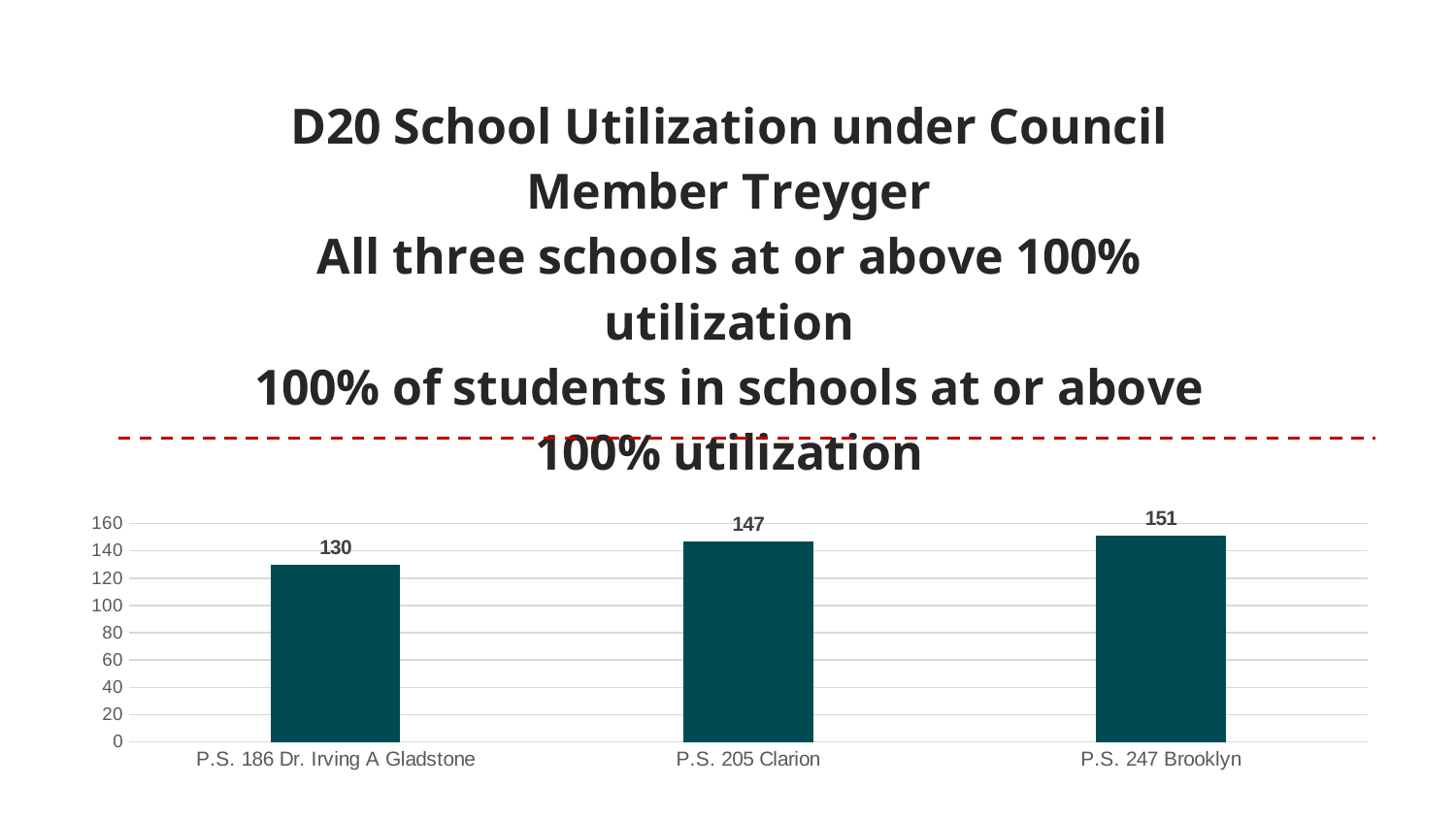
Which school has the lowest value? P.S. 186 Dr. Irving A Gladstone What kind of chart is shown on the slide? bar chart What is the value for P.S. 247 Brooklyn? 151 Do the values rise or fall from left to right across the schools? rise Which is larger, the value for P.S. 205 Clarion or the value for P.S. 186 Dr. Irving A Gladstone? P.S. 205 Clarion Which school has the highest value? P.S. 247 Brooklyn What is the value for P.S. 186 Dr. Irving A Gladstone? 130 How many schools are shown in the chart? 3 Is the value for P.S. 186 Dr. Irving A Gladstone greater or less than 100? greater What is the value for P.S. 205 Clarion? 147 What is the difference between the values for P.S. 247 Brooklyn and P.S. 186 Dr. Irving A Gladstone? 21 What is the difference between the values for P.S. 205 Clarion and P.S. 186 Dr. Irving A Gladstone? 17